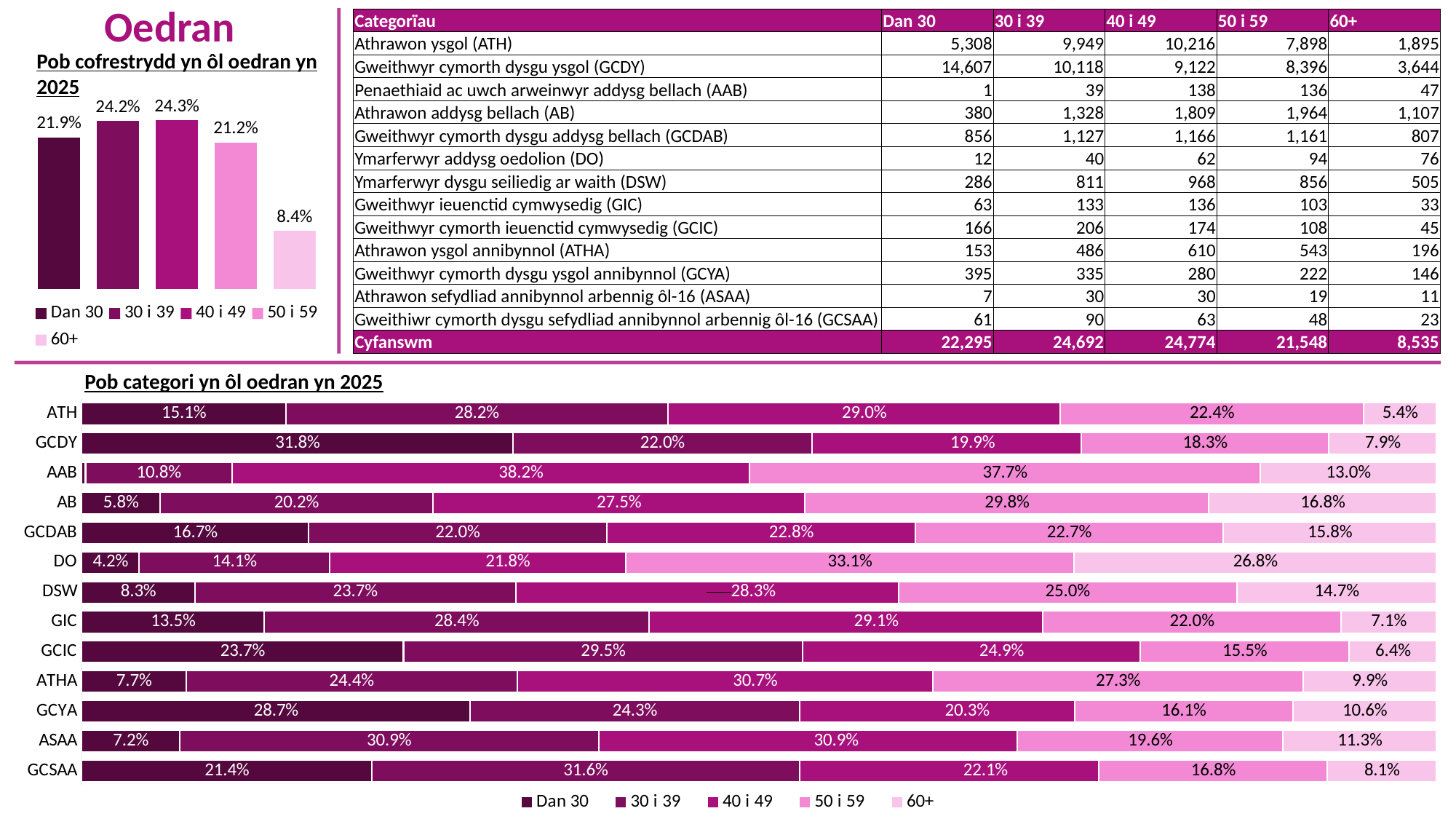
In the chart 'Pob categori yn ôl oedran yn 2025', what is the Dan 30 share for GCDY? 31.8% In the chart 'Pob categori yn ôl oedran yn 2025', which category has the largest Dan 30 segment? GCDY In the chart 'Pob cofrestrydd yn ôl oedran yn 2025', what is the value for 40 i 49? 24.3% How many series does the legend of the chart 'Pob categori yn ôl oedran yn 2025' list? 5 In the chart 'Pob categori yn ôl oedran yn 2025', is the 50 i 59 segment larger for AB or for GCYA? AB In the chart 'Pob categori yn ôl oedran yn 2025', what is the 60+ share for DO? 26.8% What kind of chart is 'Pob cofrestrydd yn ôl oedran yn 2025'? Bar chart In the chart 'Pob categori yn ôl oedran yn 2025', what is the difference between the 40 i 49 shares for ATHA and GCYA? 10.4% In the chart 'Pob cofrestrydd yn ôl oedran yn 2025', how many bars are plotted? 5 How many categories are shown in the chart 'Pob categori yn ôl oedran yn 2025'? 13 In the chart 'Pob cofrestrydd yn ôl oedran yn 2025', what is the difference between the values for 30 i 39 and 60+? 15.8% In the chart 'Pob cofrestrydd yn ôl oedran yn 2025', which age group has the lowest value? 60+